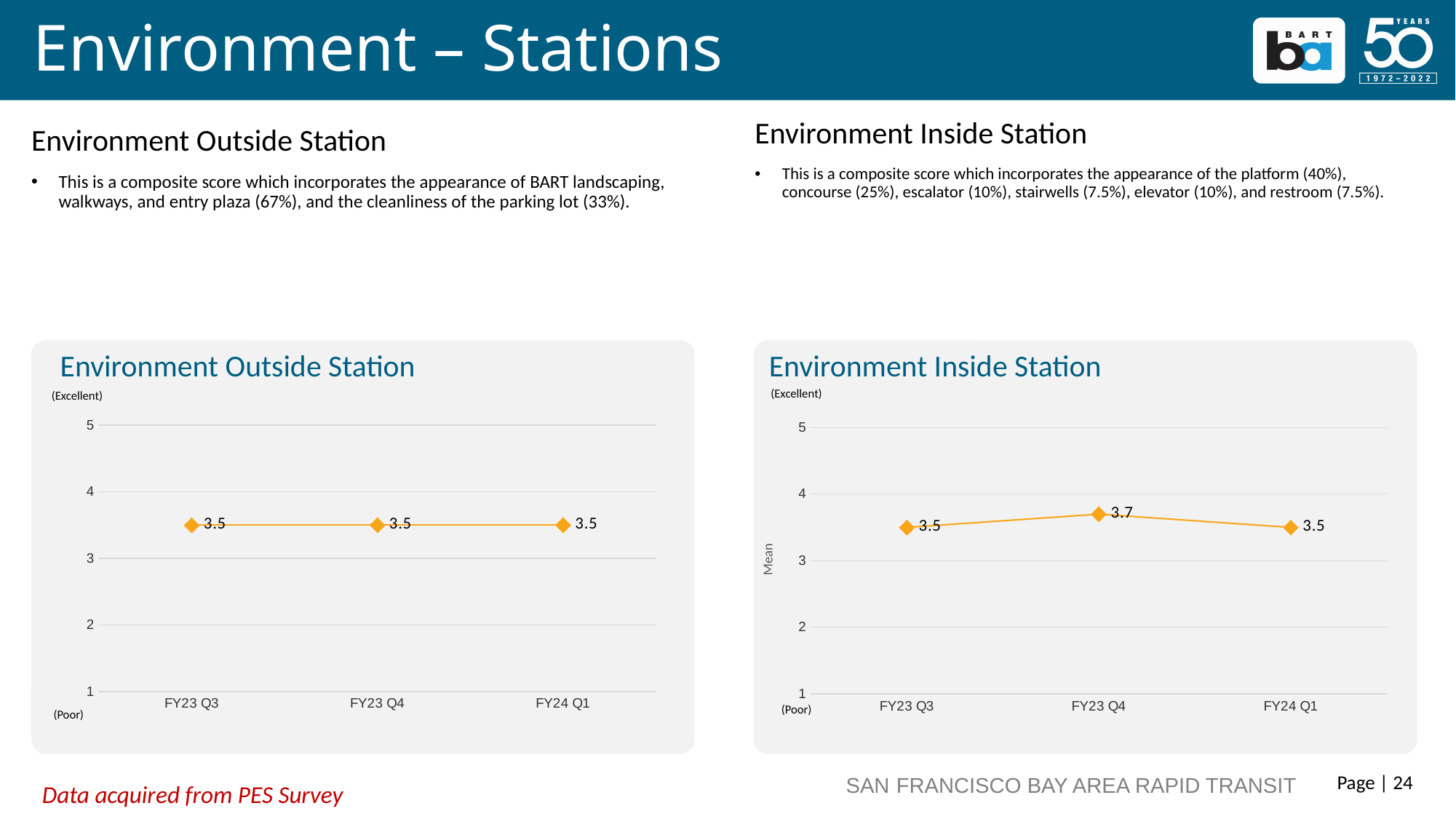
What is the label on the vertical axis of the Environment Inside Station chart? Mean In the Environment Inside Station chart, what is the value for FY23 Q4? 3.7 In the Environment Inside Station chart, what is the value for FY24 Q1? 3.5 What kind of chart is the Environment Inside Station chart? line chart In the Environment Inside Station chart, do the values rise or fall from FY23 Q4 to FY24 Q1? fall How many quarters are plotted in the Environment Outside Station chart? 3 In the Environment Outside Station chart, what is the value for FY23 Q3? 3.5 In the Environment Outside Station chart, is the value for FY23 Q4 greater or less than 4? less In the Environment Inside Station chart, which quarter has the highest value? FY23 Q4 In the Environment Outside Station chart, do the values rise, fall, or stay flat from FY23 Q3 to FY24 Q1? stay flat In the Environment Inside Station chart, what is the difference between the FY23 Q4 value and the FY23 Q3 value? 0.2 In the Environment Inside Station chart, which is larger, the value for FY23 Q4 or the value for FY24 Q1? FY23 Q4